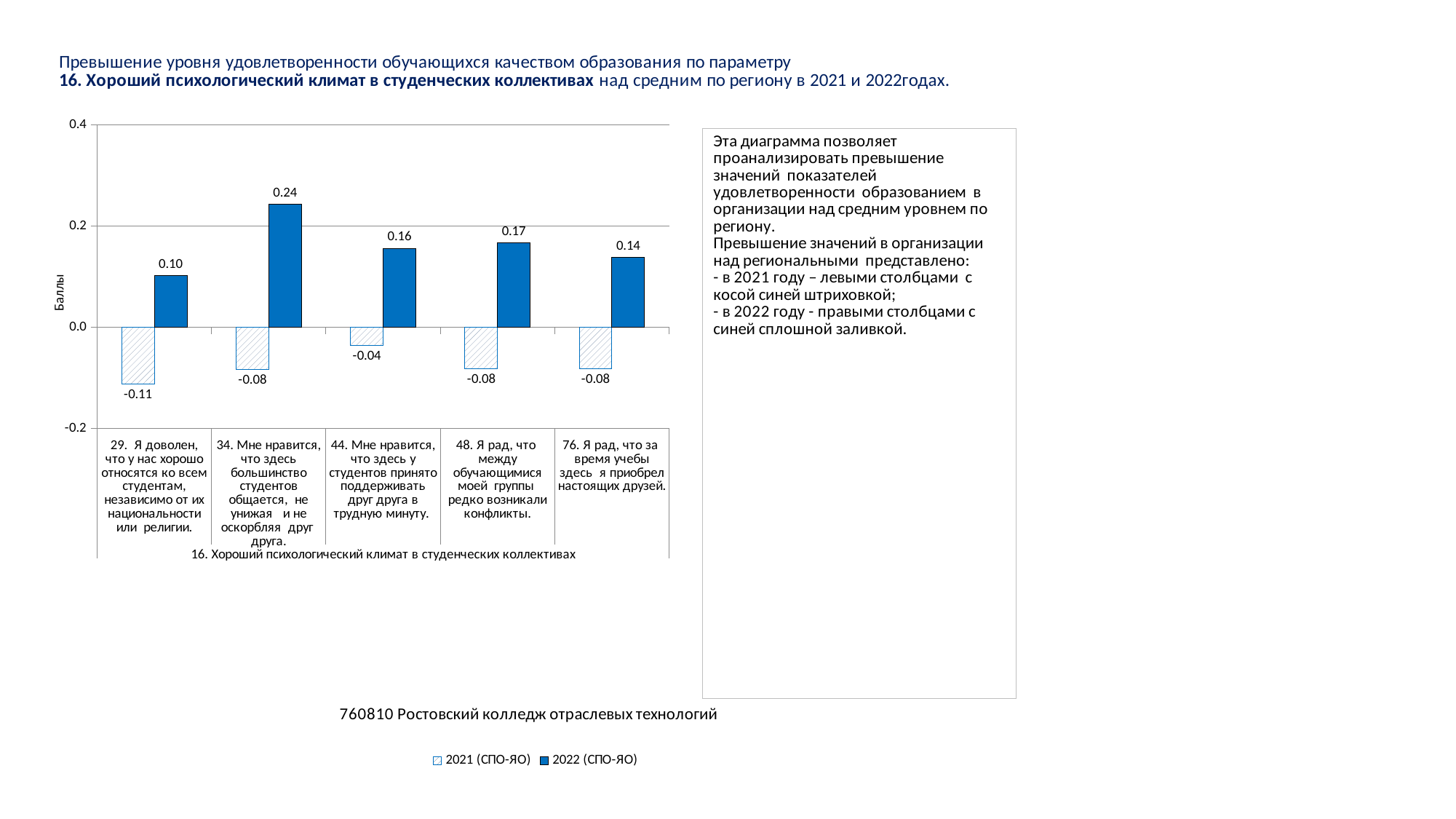
Which is larger for the 2022 (СПО-ЯО) series: the value for category 44 or the value for category 29? 44. Мне нравится, что здесь у студентов принято поддерживать друг друга в трудную минуту. Which category has the lowest value for the 2021 (СПО-ЯО) series? 29. Я доволен, что у нас хорошо относятся ко всем студентам, независимо от их национальности или религии. How many series does the legend list? 2 What is the label of the vertical axis of the chart? Баллы What is the value for 2021 (СПО-ЯО) for category "29. Я доволен, что у нас хорошо относятся ко всем студентам, независимо от их национальности или религии."? -0.11 What is the value for 2022 (СПО-ЯО) for category "34. Мне нравится, что здесь большинство студентов общается, не унижая и не оскорбляя друг друга."? 0.24 What is the value for 2022 (СПО-ЯО) for category "76. Я рад, что за время учебы здесь я приобрел настоящих друзей."? 0.14 What kind of chart is shown on the slide? Bar chart How many categories are shown on the x axis of the chart? 5 Which category has the highest value for the 2022 (СПО-ЯО) series? 34. Мне нравится, что здесь большинство студентов общается, не унижая и не оскорбляя друг друга. What is the value for 2021 (СПО-ЯО) for category "44. Мне нравится, что здесь у студентов принято поддерживать друг друга в трудную минуту."? -0.04 What is the difference between the 2022 (СПО-ЯО) and 2021 (СПО-ЯО) values for category "48. Я рад, что между обучающимися моей группы редко возникали конфликты."? 0.25